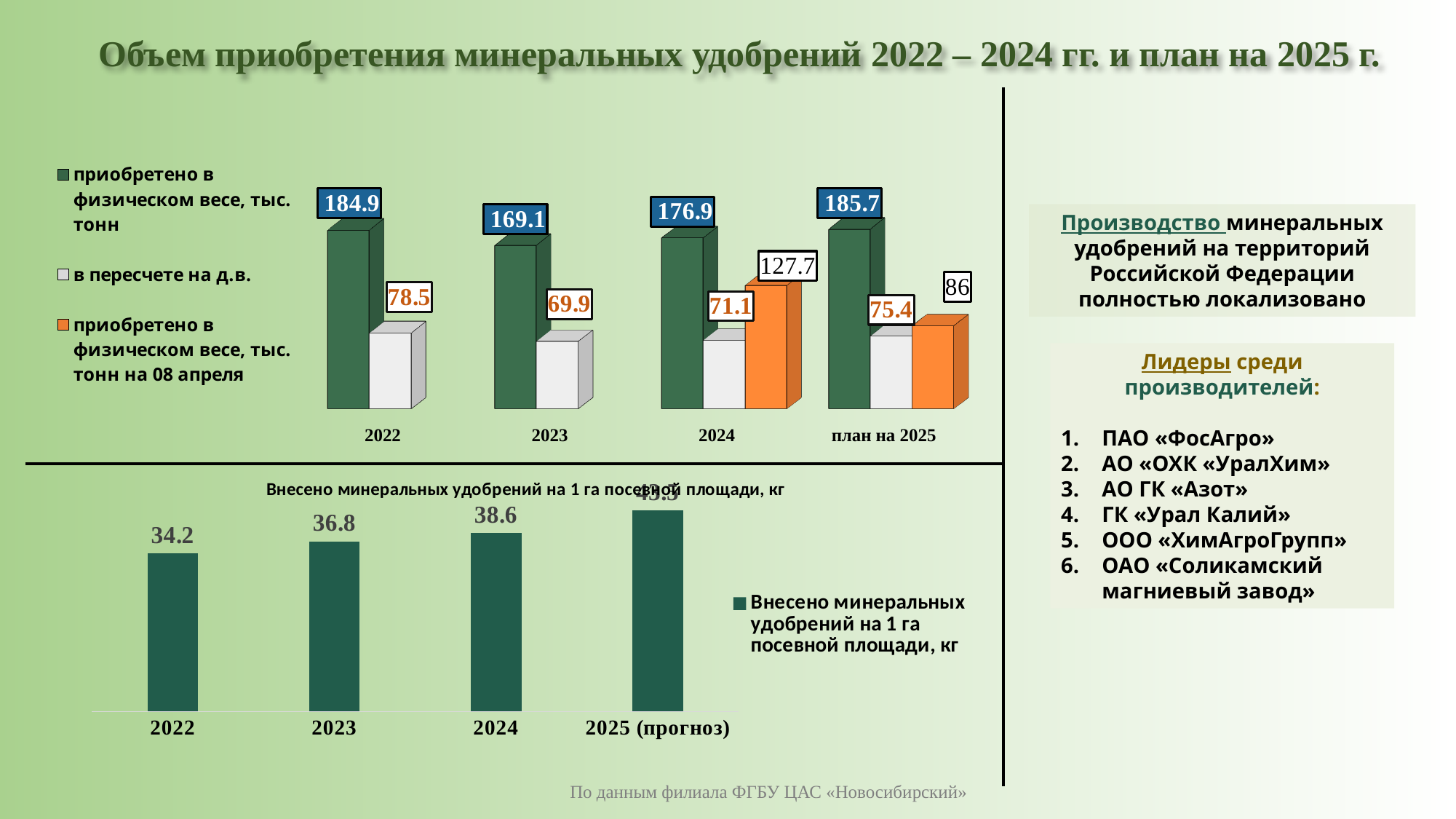
In the bottom chart 'Внесено минеральных удобрений на 1 га посевной площади, кг', what is the value for 2023? 36.8 In the bottom chart 'Внесено минеральных удобрений на 1 га посевной площади, кг', do the values rise or fall from 2022 to 2025 (прогноз)? rise In the top chart, which year has the lowest value for 'приобретено в физическом весе, тыс. тонн'? 2023 In the top chart, what is the value of 'приобретено в физическом весе, тыс. тонн на 08 апреля' for 'план на 2025'? 86 In the top chart, what is the value of 'приобретено в физическом весе, тыс. тонн на 08 апреля' for 2024? 127.7 In the top chart, what is the value of 'приобретено в физическом весе, тыс. тонн' for 2022? 184.9 In the top chart, what is the difference between the 'приобретено в физическом весе, тыс. тонн' values for 'план на 2025' and 2024? 8.8 In the bottom chart 'Внесено минеральных удобрений на 1 га посевной площади, кг', what is the difference between the values for 2024 and 2022? 4.4 In the top chart, which is larger: the 'в пересчете на д.в.' value for 2022 or for 2024? 2022 In the top chart, what is the value of 'в пересчете на д.в.' for 2023? 69.9 What kind of chart is the bottom chart 'Внесено минеральных удобрений на 1 га посевной площади, кг'? bar chart In the top chart, how many series does the legend list? 3